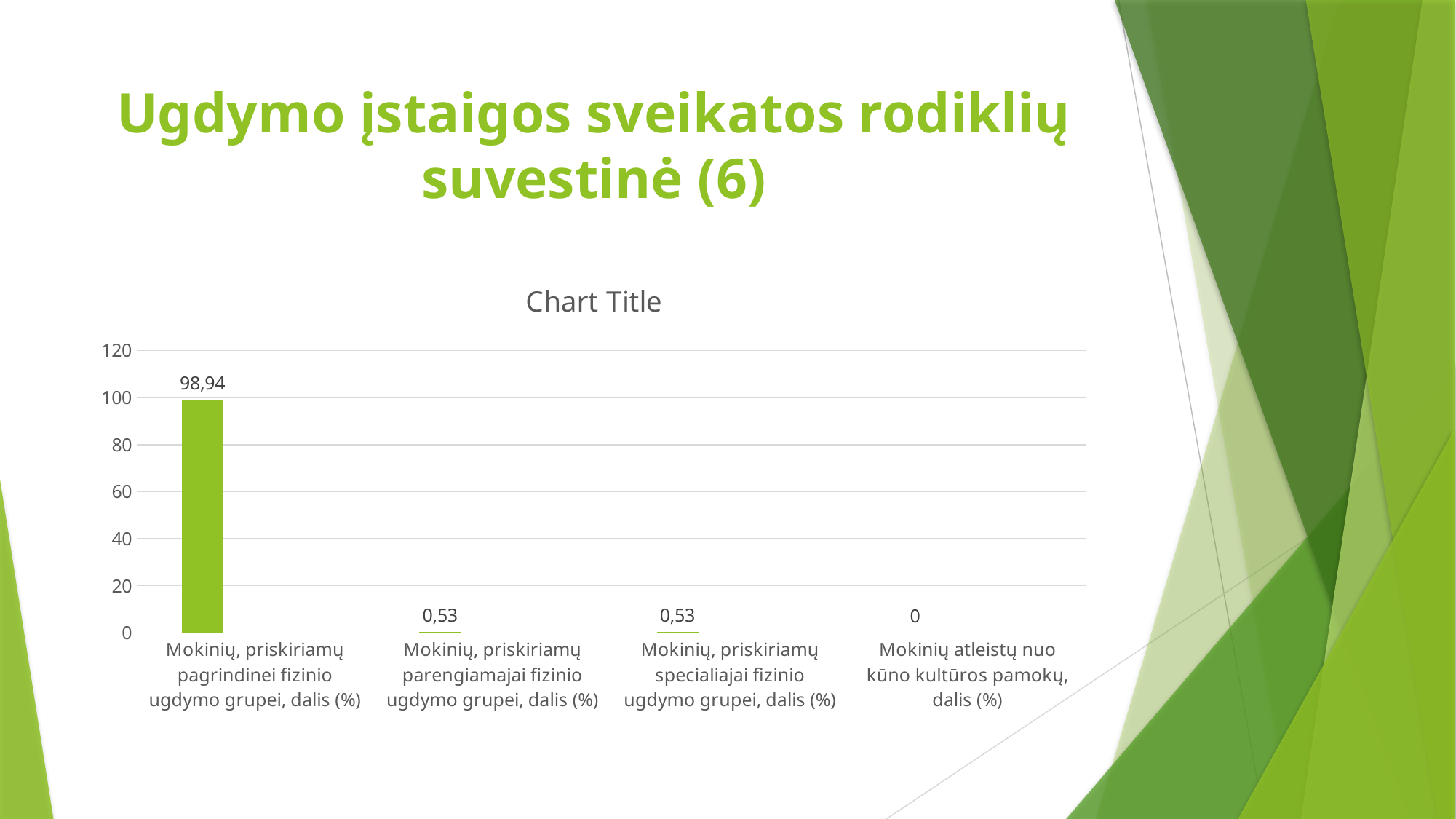
What is the value for "Mokinių, priskiriamų pagrindinei fizinio ugdymo grupei, dalis (%)"? 98,94 What is the value for "Mokinių, priskiriamų parengiamajai fizinio ugdymo grupei, dalis (%)"? 0,53 Which is larger: the value for "Mokinių, priskiriamų specialiajai fizinio ugdymo grupei, dalis (%)" or the value for "Mokinių atleistų nuo kūno kultūros pamokų, dalis (%)"? Mokinių, priskiriamų specialiajai fizinio ugdymo grupei, dalis (%) What is the value for "Mokinių, priskiriamų specialiajai fizinio ugdymo grupei, dalis (%)"? 0,53 What is the difference between the value for "Mokinių, priskiriamų pagrindinei fizinio ugdymo grupei, dalis (%)" and the value for "Mokinių, priskiriamų parengiamajai fizinio ugdymo grupei, dalis (%)"? 98,41 What is the value for "Mokinių atleistų nuo kūno kultūros pamokų, dalis (%)"? 0 How many categories are shown on the x axis of the chart? 4 Which category has the highest value? Mokinių, priskiriamų pagrindinei fizinio ugdymo grupei, dalis (%) What is the title of the chart? Chart Title Is the value for "Mokinių, priskiriamų pagrindinei fizinio ugdymo grupei, dalis (%)" greater or less than 80? greater What kind of chart is shown on the slide? bar chart Which category has the lowest value? Mokinių atleistų nuo kūno kultūros pamokų, dalis (%)